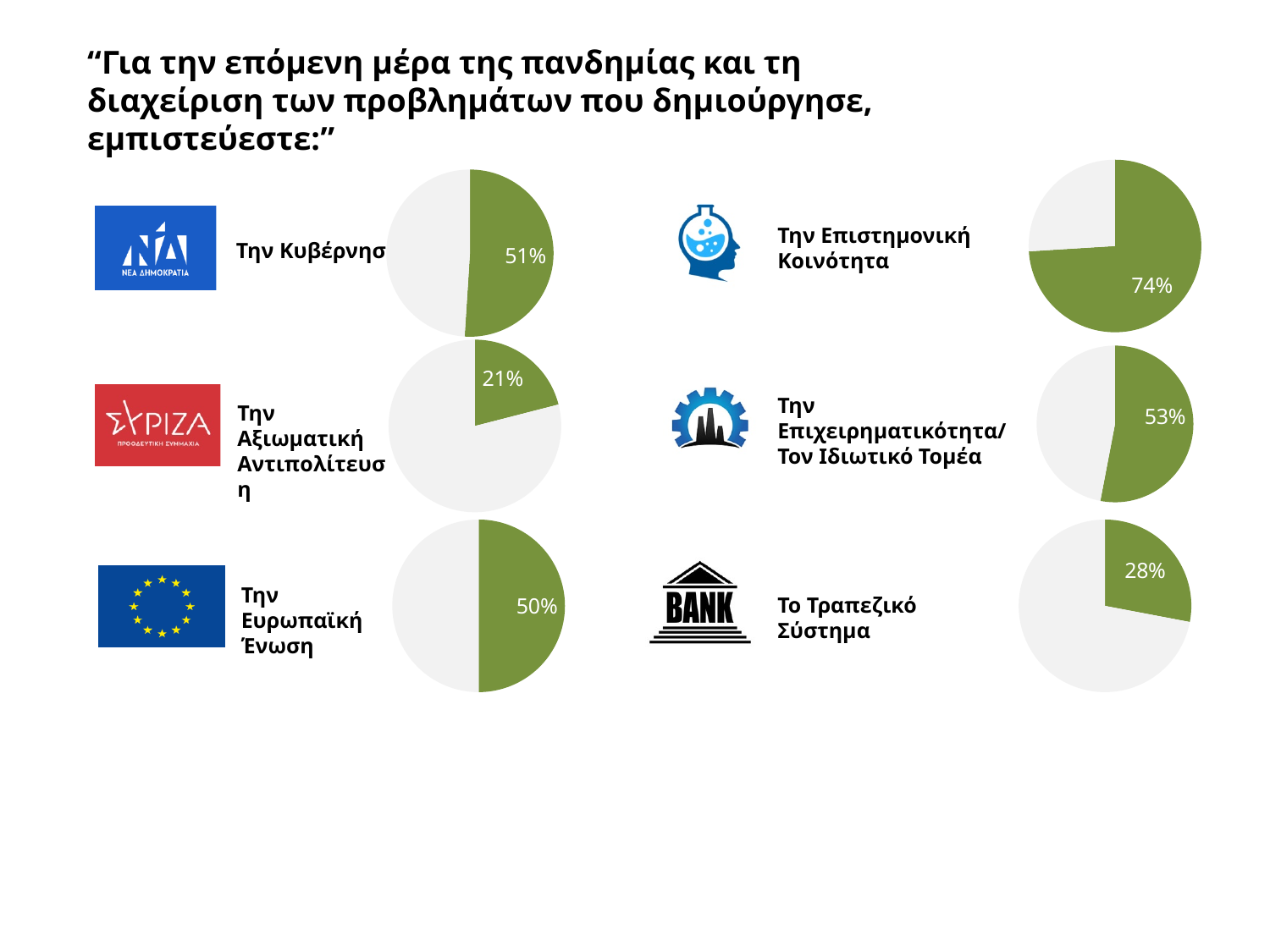
Across all six pie charts on the slide, which institution has the highest labelled percentage? Την Επιστημονική Κοινότητα In the pie chart next to 'Την Αξιωματική Αντιπολίτευση', what percentage is labelled on the green slice? 21% How many pie charts are shown on the slide? 6 Across all six pie charts on the slide, which institution has the lowest labelled percentage? Την Αξιωματική Αντιπολίτευση In the pie chart next to 'Την Ευρωπαϊκή Ένωση', what value is shown on the green slice? 50% What is the difference between the percentage for 'Την Επιστημονική Κοινότητα' and the percentage for 'Το Τραπεζικό Σύστημα'? 46% What type of chart is used next to each institution on the slide? Pie chart In the pie chart next to 'Το Τραπεζικό Σύστημα', what percentage does the green slice show? 28% In the pie chart next to 'Την Επιχειρηματικότητα/Τον Ιδιωτικό Τομέα', what percentage is labelled? 53% Which has the larger labelled percentage: the pie chart for 'Την Κυβέρνηση' or the pie chart for 'Το Τραπεζικό Σύστημα'? Την Κυβέρνηση In the pie chart next to 'Την Επιστημονική Κοινότητα', what percentage is shown? 74% In the pie chart next to 'Την Κυβέρνηση', what percentage does the green slice show? 51%